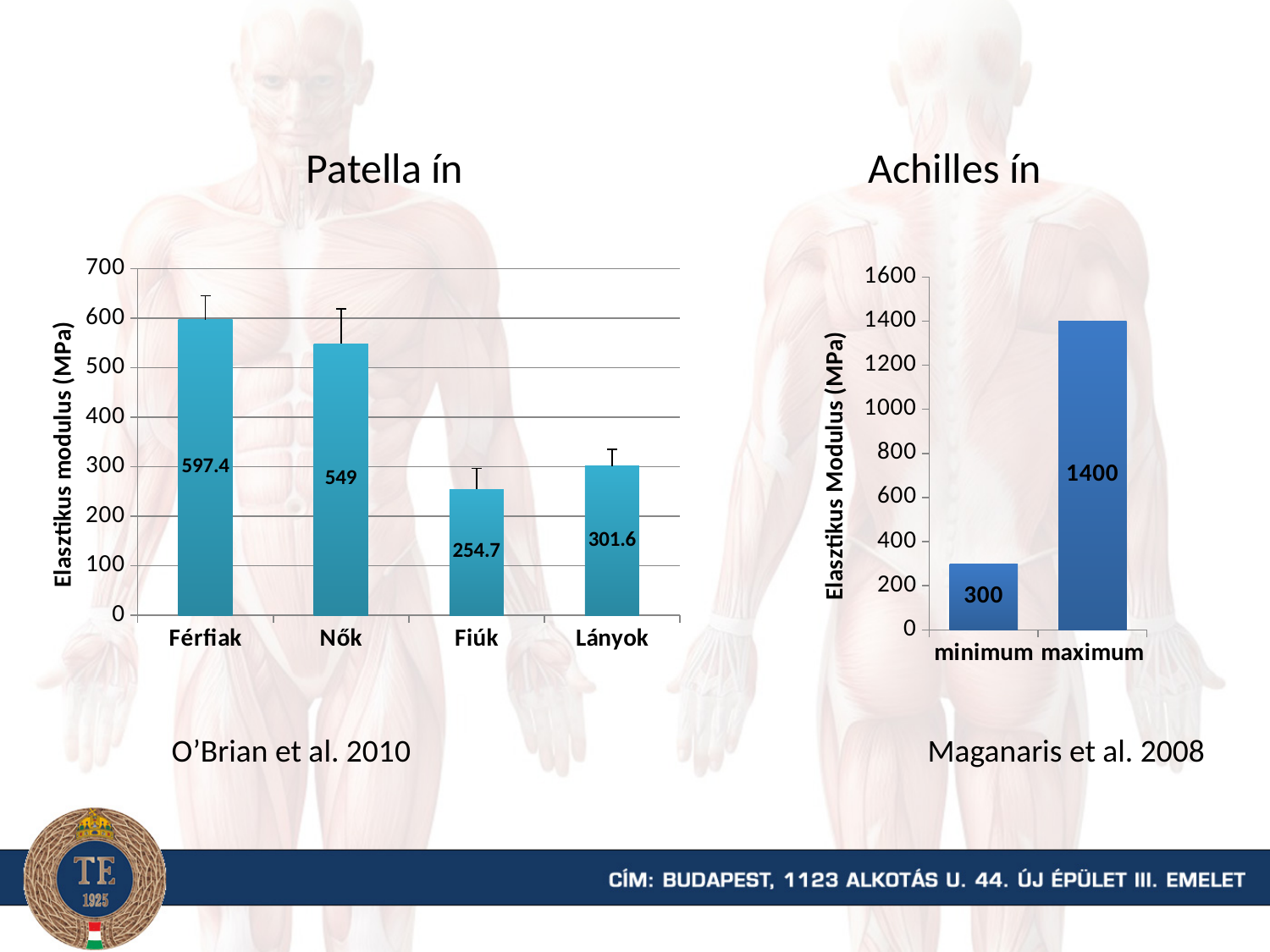
What kind of chart is the Achilles ín chart? Bar chart In the Patella ín chart, what is the value for Férfiak? 597.4 What is the y-axis label of the Patella ín chart? Elasztikus modulus (MPa) In the Achilles ín chart, what is the value for maximum? 1400 In the Patella ín chart, which is larger, the value for Lányok or the value for Fiúk? Lányok In the Patella ín chart, what is the difference between the values for Férfiak and Nők? 48.4 In the Patella ín chart, what is the value for Fiúk? 254.7 In the Patella ín chart, which category has the highest value? Férfiak In the Achilles ín chart, what is the value for minimum? 300 In the Patella ín chart, which category has the lowest value? Fiúk In the Patella ín chart, how many categories are shown on the x axis? 4 In the Achilles ín chart, what is the difference between the maximum and minimum values? 1100